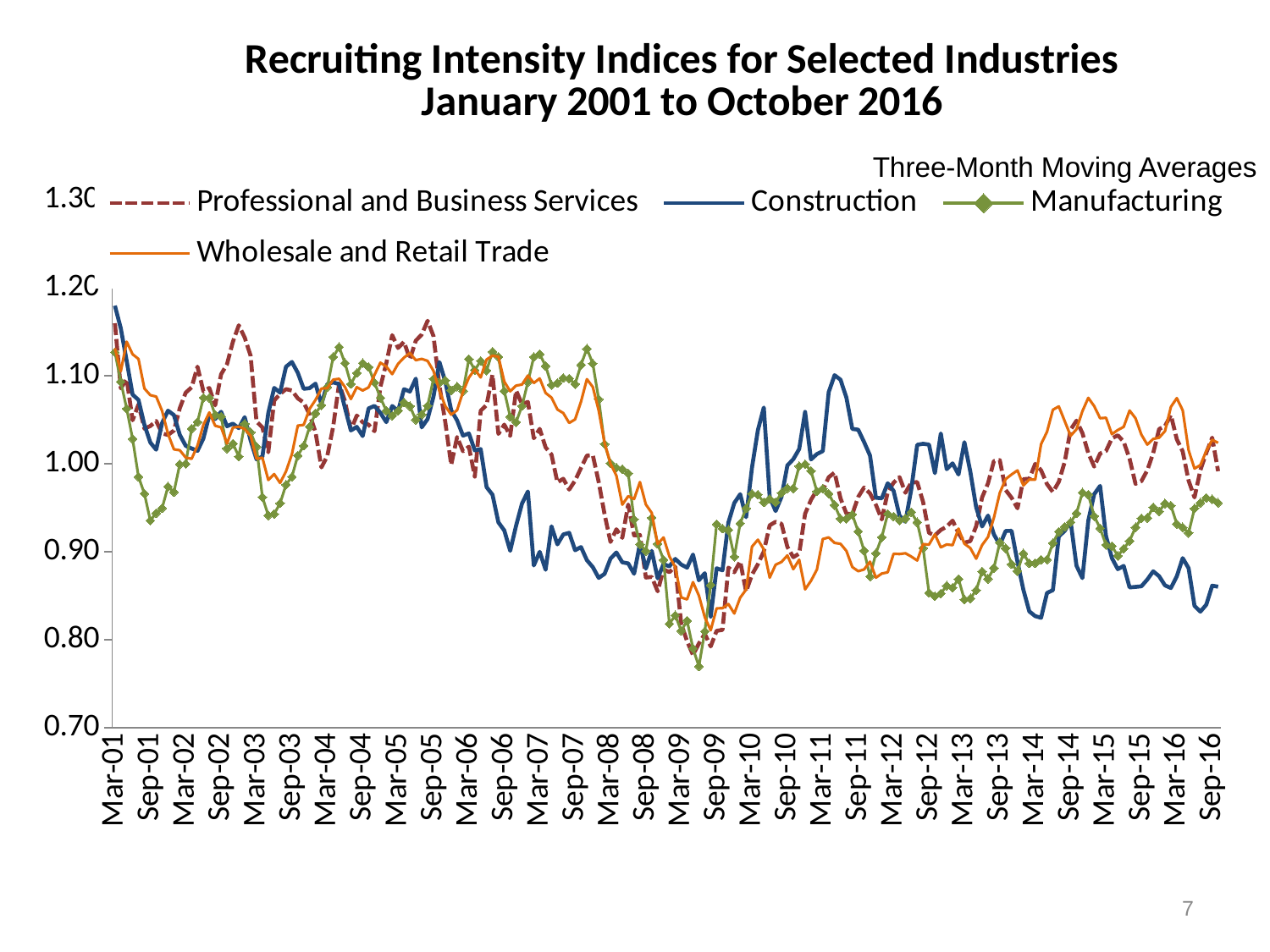
Is the value for Wholesale and Retail Trade at Mar-14 greater or less than 1.00? less Is the value for Construction at Mar-01 greater or less than 1.10? greater Which series is drawn with a dashed line? Professional and Business Services What kind of chart is shown on the slide? Line chart How many series does the legend list? 4 Is the value for Construction at Sep-16 greater or less than 0.90? less Does the Construction series overall rise or fall from Mar-01 to Sep-16? Fall Which series reaches the lowest point on the chart? Manufacturing At Mar-14, which is higher: Construction or Wholesale and Retail Trade? Wholesale and Retail Trade At Sep-16, which is higher: Wholesale and Retail Trade or Construction? Wholesale and Retail Trade What is the title of the chart? Recruiting Intensity Indices for Selected Industries January 2001 to October 2016